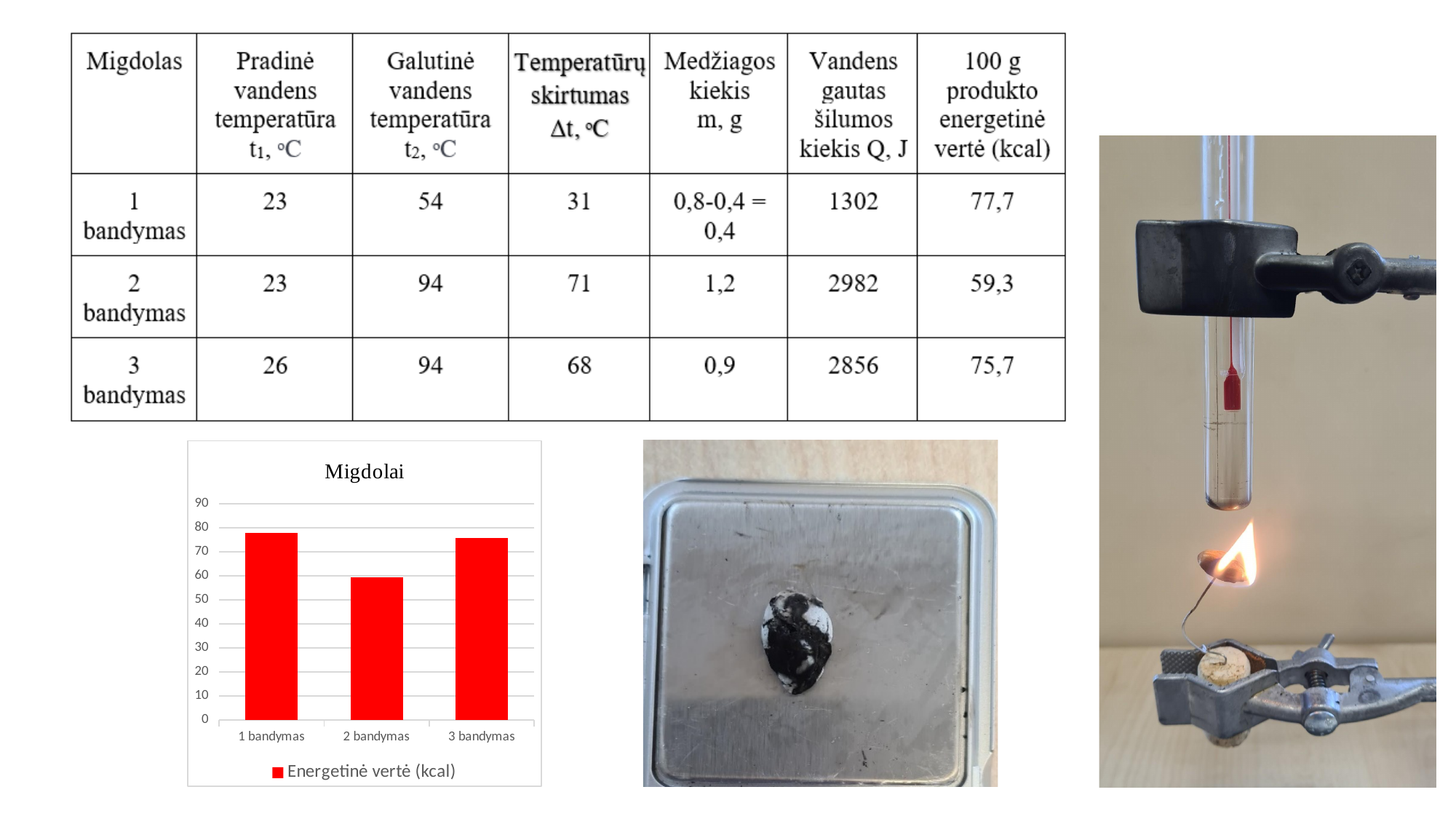
How many bars (categories) does the "Migdolai" chart show? 3 What type of chart is shown under the title "Migdolai"? bar chart Which category has the lowest value in the "Migdolai" chart? 2 bandymas In the "Migdolai" chart, which is larger: the value for 2 bandymas or for 3 bandymas? 3 bandymas In the "Migdolai" chart, which is larger: the value for 1 bandymas or for 2 bandymas? 1 bandymas In the "Migdolai" chart, is the value for 3 bandymas greater or less than 80? less In the "Migdolai" chart, is the value for 2 bandymas greater or less than 70? less What is the legend entry of the "Migdolai" chart? Energetinė vertė (kcal) In the "Migdolai" chart, does the value fall or rise from 1 bandymas to 2 bandymas? fall In the "Migdolai" chart, is the value for 1 bandymas greater or less than 70? greater How many series does the legend of the "Migdolai" chart list? 1 What colour are the bars in the "Migdolai" chart? red